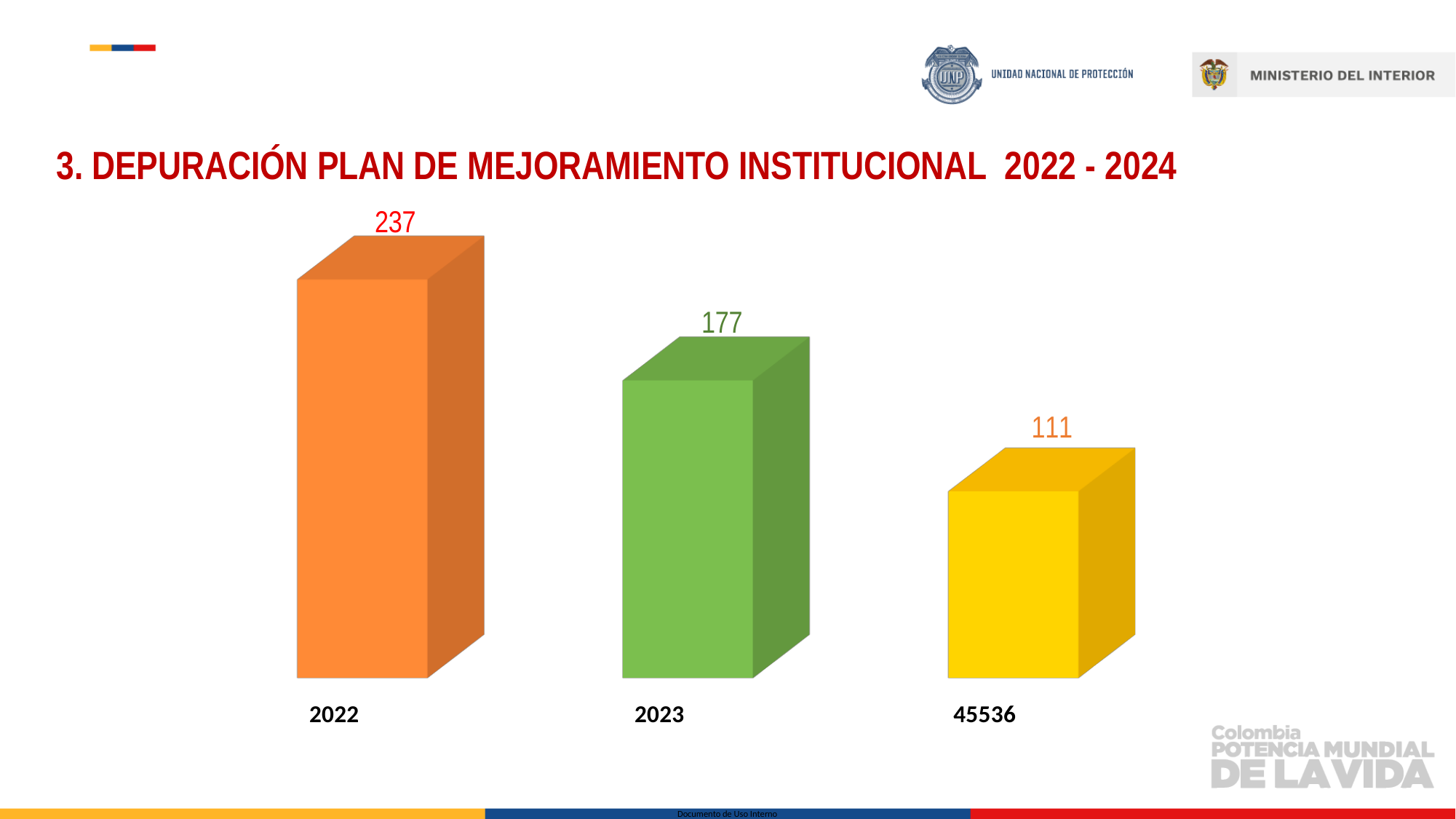
What is the difference between the values for 2023 and the category labelled 45536? 66 What is the value for 2023? 177 What kind of chart is shown on the slide? bar chart Do the values rise or fall from left to right along the x axis? fall What is the difference between the values for 2022 and 2023? 60 How many bars are shown in the chart? 3 What is the value for 2022? 237 Which is larger, the value for 2022 or the value for 2023? 2022 Which category has the highest value? 2022 Which category has the lowest value? 45536 What colour is the bar for 2023? green What is the value for the category labelled 45536? 111